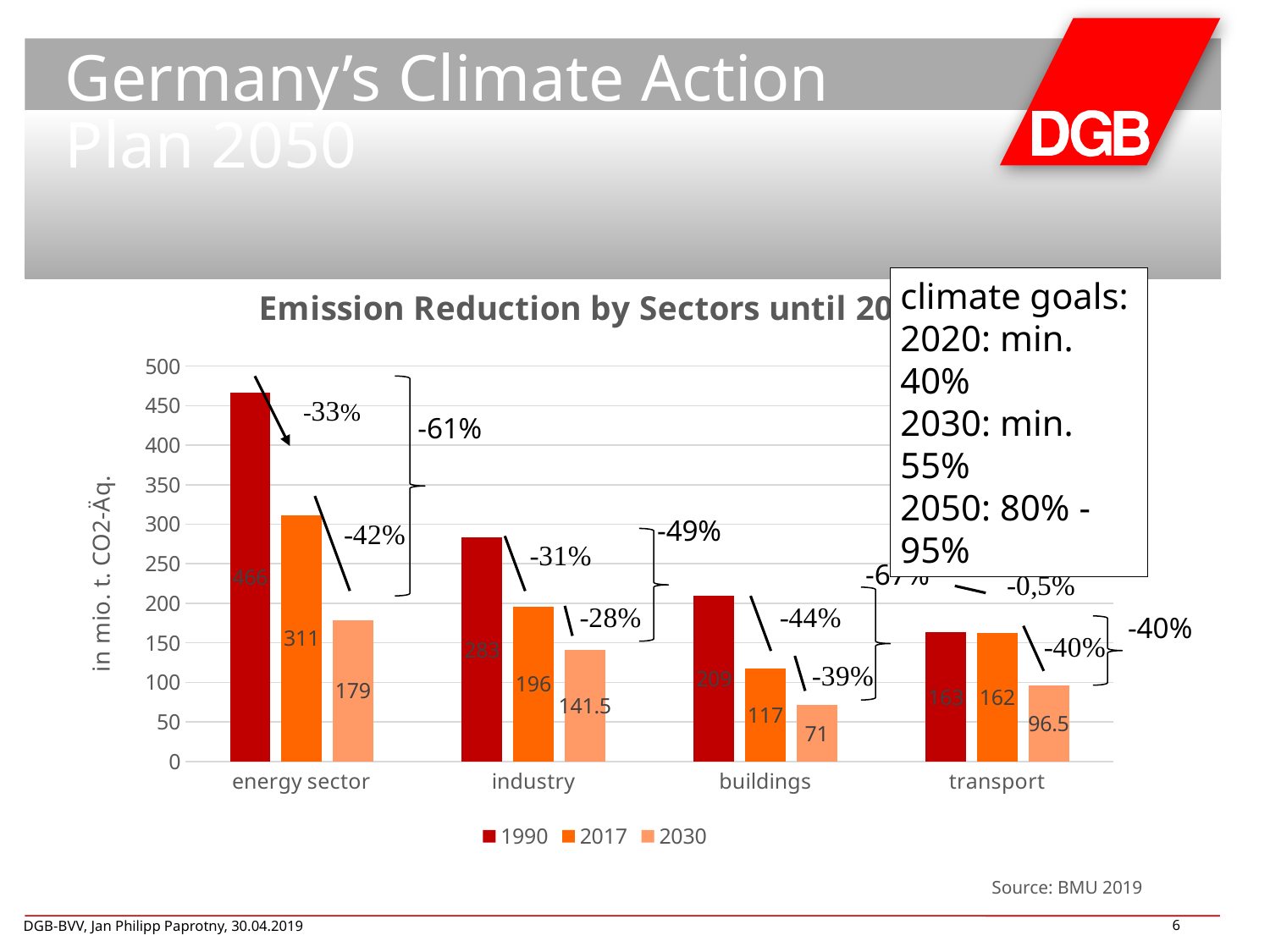
What is the 2030 value for industry? 141.5 What is the 2017 value for the energy sector? 311 Is the 1990 value for the energy sector greater or less than 400? greater Which is larger, the 2017 value for industry or the 2017 value for transport? industry What is the difference between the 2017 and 2030 values for the energy sector? 132 Which sector has the highest 1990 value? energy sector How many sectors are shown on the x axis? 4 What is the 2030 value for transport? 96.5 What kind of chart is shown on the slide? bar chart How many series does the legend list? 3 Which sector has the lowest 2030 value? buildings What is the 2017 value for buildings? 117